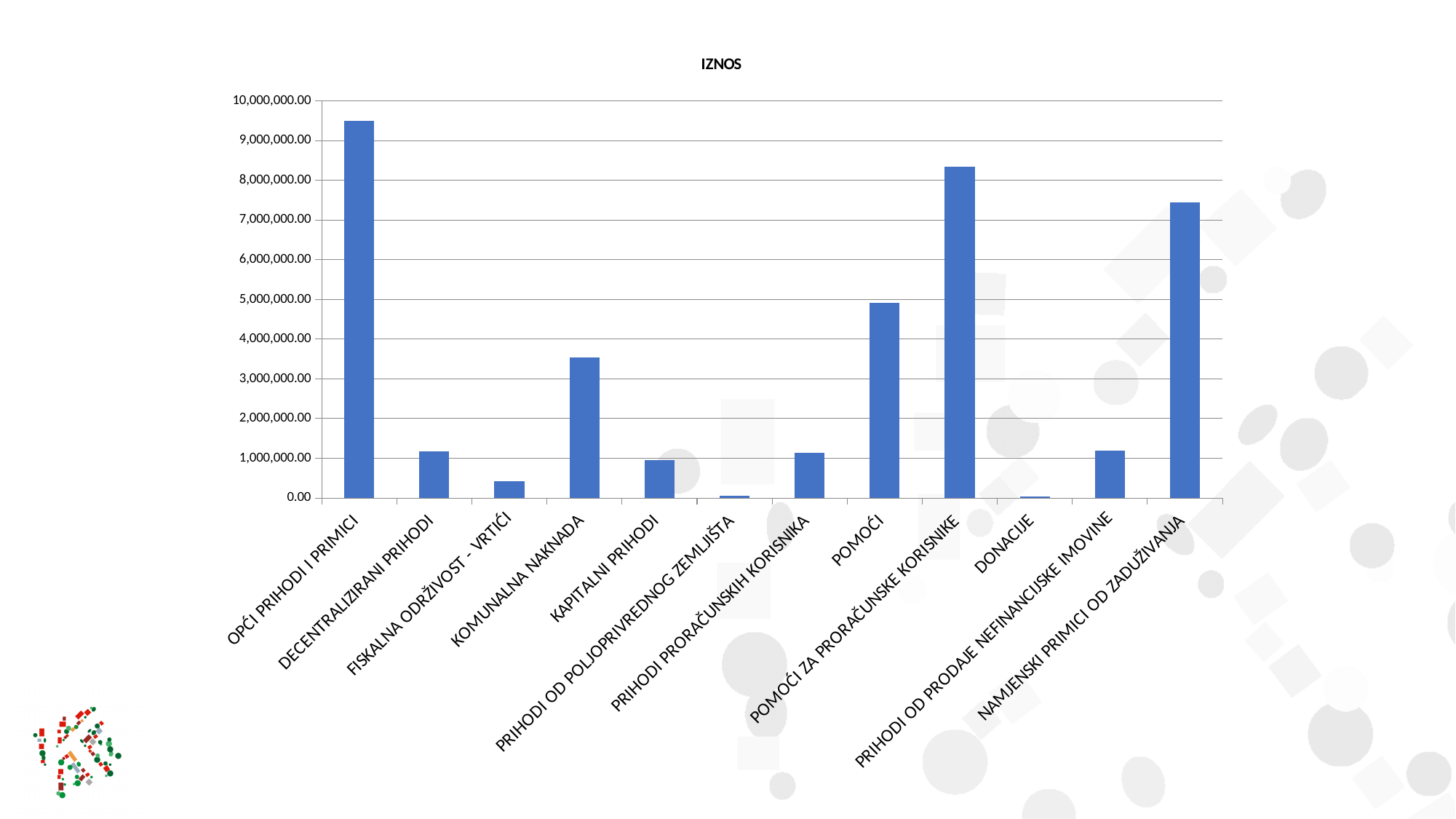
What is the highest value shown on the y axis? 10,000,000.00 How many categories are plotted on the x axis? 12 Is the value for FISKALNA ODRŽIVOST - VRTIĆI greater or less than 1,000,000.00? less Which category has the highest value? OPĆI PRIHODI I PRIMICI Which is larger, the value for POMOĆI ZA PRORAČUNSKE KORISNIKE or the value for NAMJENSKI PRIMICI OD ZADUŽIVANJA? POMOĆI ZA PRORAČUNSKE KORISNIKE What kind of chart is shown on the slide? bar chart What is the title of the chart? IZNOS Is the value for OPĆI PRIHODI I PRIMICI greater or less than 9,000,000.00? greater Which is larger, the value for KOMUNALNA NAKNADA or the value for POMOĆI? POMOĆI Is the value for POMOĆI ZA PRORAČUNSKE KORISNIKE greater or less than 8,000,000.00? greater